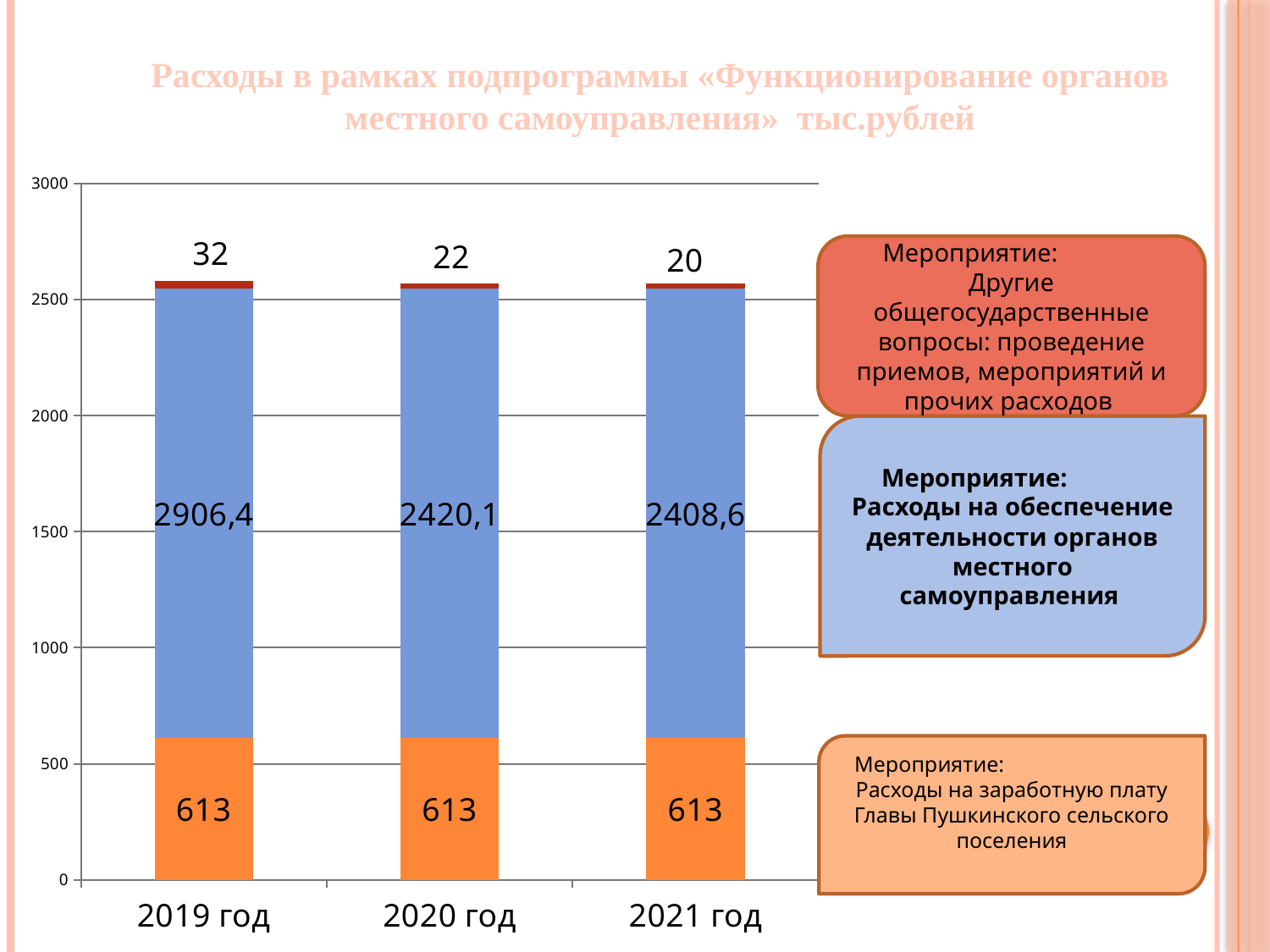
Which is larger: the blue segment value for 2020 год or for 2021 год? 2020 год Do the values of the red segment (Другие общегосударственные вопросы) rise or fall from 2019 год to 2021 год? Fall In which year is the red segment (Другие общегосударственные вопросы) the lowest? 2021 год What is the difference between the red segment values for 2019 год and 2021 год? 12 In which year is the blue segment (Расходы на обеспечение деятельности органов местного самоуправления) the highest? 2019 год What is the value of the top red segment (Другие общегосударственные вопросы) for 2021 год? 20 What type of chart is shown on the slide? Stacked bar chart What is the value of the orange segment (Расходы на заработную плату Главы Пушкинского сельского поселения) for 2019 год? 613 What is the difference between the blue segment values for 2019 год and 2020 год? 486,3 What is the value of the blue segment for 2021 год? 2408,6 How many years (categories) are shown on the x axis of the chart? 3 What is the value of the blue segment (Расходы на обеспечение деятельности органов местного самоуправления) for 2020 год? 2420,1